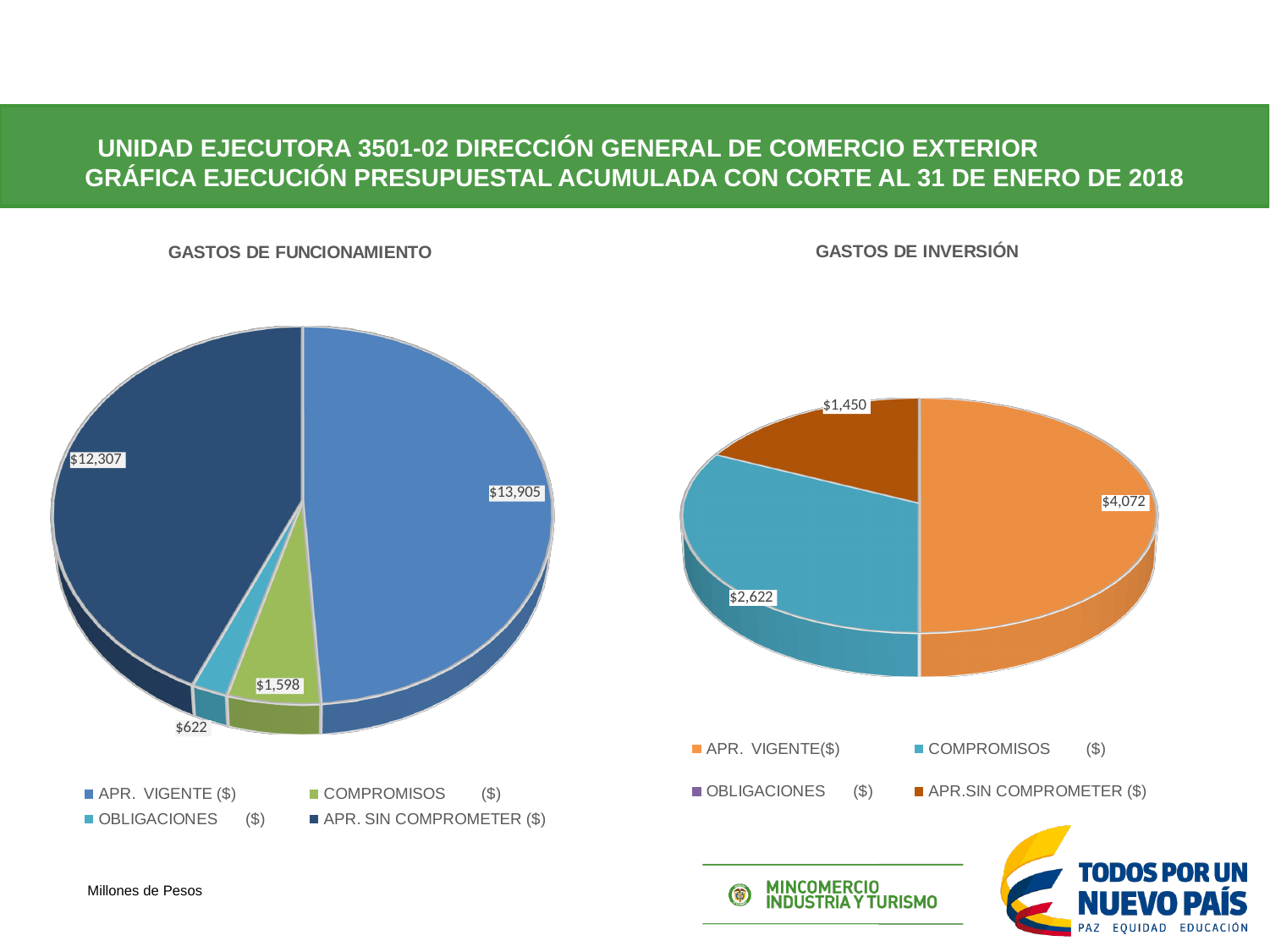
In the GASTOS DE FUNCIONAMIENTO chart, what is the difference between the APR. VIGENTE ($) value and the APR. SIN COMPROMETER ($) value? $1,598 In the GASTOS DE FUNCIONAMIENTO chart, which category has the smallest slice? OBLIGACIONES ($) How many entries does the legend of the GASTOS DE FUNCIONAMIENTO chart list? 4 What type of chart is used for GASTOS DE INVERSIÓN? Pie chart In the GASTOS DE INVERSIÓN chart, what is the difference between the COMPROMISOS ($) value and the APR.SIN COMPROMETER ($) value? $1,172 In the GASTOS DE FUNCIONAMIENTO chart, what is the value of the OBLIGACIONES ($) slice? $622 In the GASTOS DE INVERSIÓN chart, which category has the largest slice? APR. VIGENTE($) In the GASTOS DE INVERSIÓN chart, what is the value of the APR.SIN COMPROMETER ($) slice? $1,450 In the GASTOS DE INVERSIÓN chart, what is the value of the COMPROMISOS ($) slice? $2,622 In the GASTOS DE FUNCIONAMIENTO chart, what is the value of the APR. SIN COMPROMETER ($) slice? $12,307 In the GASTOS DE FUNCIONAMIENTO chart, which is larger: COMPROMISOS ($) or OBLIGACIONES ($)? COMPROMISOS ($) In the GASTOS DE FUNCIONAMIENTO chart, what is the value of the APR. VIGENTE ($) slice? $13,905